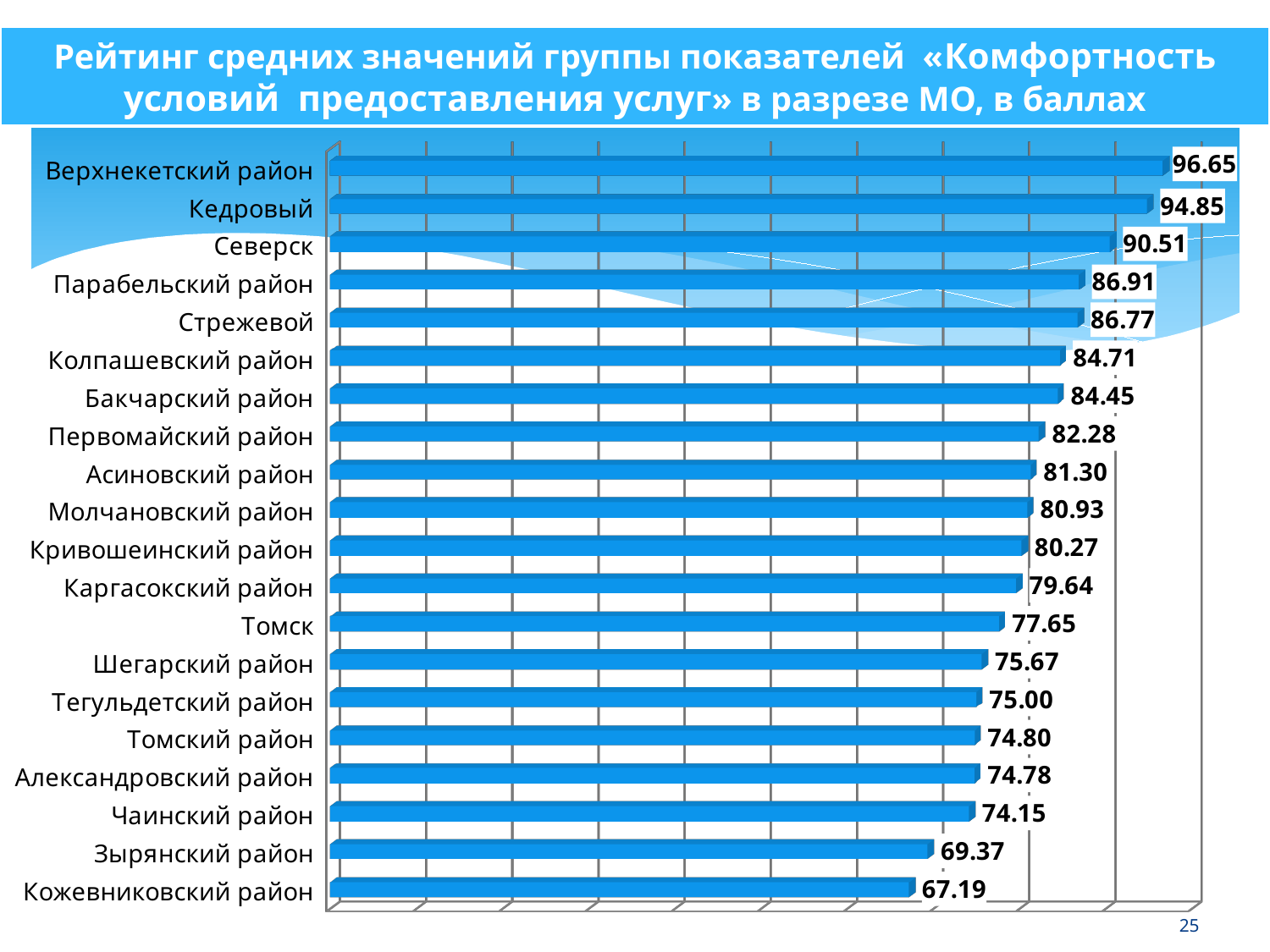
What is the value for Каргасокский район? 79.64 What is the value for Зырянский район? 69.37 What type of chart is shown on the slide? bar chart What is the difference between the values for Северск and Парабельский район? 3.60 Do the values rise or fall going from the top bar to the bottom bar? fall Which municipality has the highest value? Верхнекетский район What is the value for Томск? 77.65 Which has a larger value, Стрежевой or Колпашевский район? Стрежевой How many municipalities are shown in the chart? 20 What is the value for Верхнекетский район? 96.65 Which municipality has the lowest value? Кожевниковский район What is the difference between the values for Верхнекетский район and Кожевниковский район? 29.46